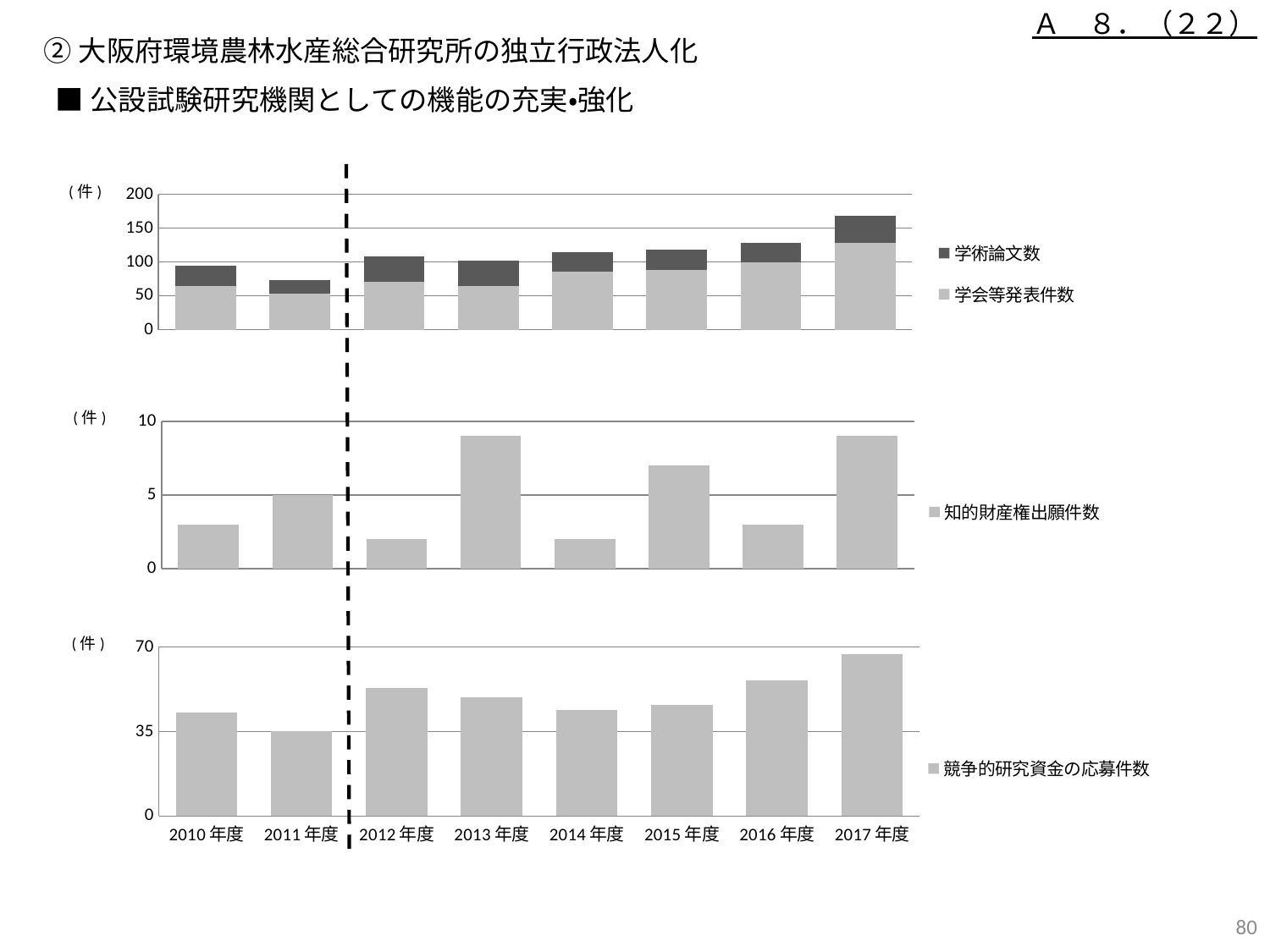
In the bottom chart (競争的研究資金の応募件数), which year has the highest value? 2017年度 In the middle chart (知的財産権出願件数), is the value for 2013年度 greater or less than 5? greater In the top chart (学術論文数 / 学会等発表件数), how many series does the legend list? 2 In the bottom chart (競争的研究資金の応募件数), what is the value for 2011年度? 35 In the top chart (学術論文数 / 学会等発表件数), is the total stacked value for 2011年度 greater or less than 100? less In the middle chart (知的財産権出願件数), which is larger, the value for 2015年度 or 2016年度? 2015年度 In the top chart (学術論文数 / 学会等発表件数), is the total stacked value for 2017年度 greater or less than 150? greater In the top chart (学術論文数 / 学会等発表件数), which year has the shortest stacked bar? 2011年度 In the top chart (学術論文数 / 学会等発表件数), which year has the tallest stacked bar? 2017年度 In the middle chart (知的財産権出願件数), what is the value for 2011年度? 5 What kind of chart is the bottom chart (競争的研究資金の応募件数)? bar chart In the bottom chart (競争的研究資金の応募件数), how many years are shown on the x axis? 8